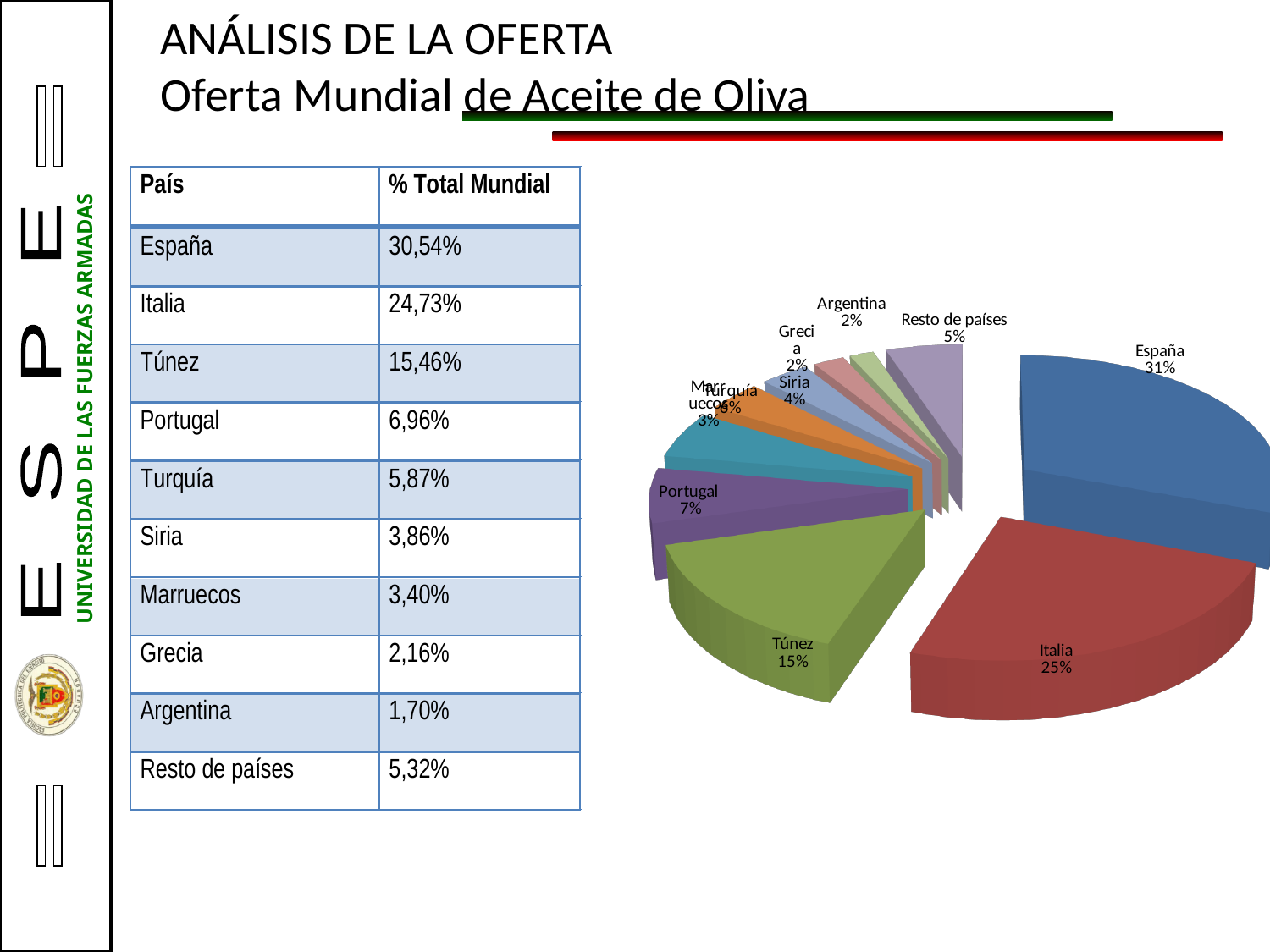
In the pie chart, what share is labelled for Italia? 25% Which slice of the pie chart is the largest? España What colour is the España slice in the pie chart? blue What kind of chart is shown on the slide? pie chart In the pie chart, what share is labelled for Portugal? 7% In the pie chart, what share is labelled for Resto de países? 5% In the pie chart, what share is labelled for Túnez? 15% In the pie chart, what share is labelled for España? 31% What is the difference between the labelled shares of España and Italia in the pie chart? 6% How many slices does the pie chart have? 10 In the pie chart, what share is labelled for Siria? 4% Which slice is larger in the pie chart, Italia or Túnez? Italia